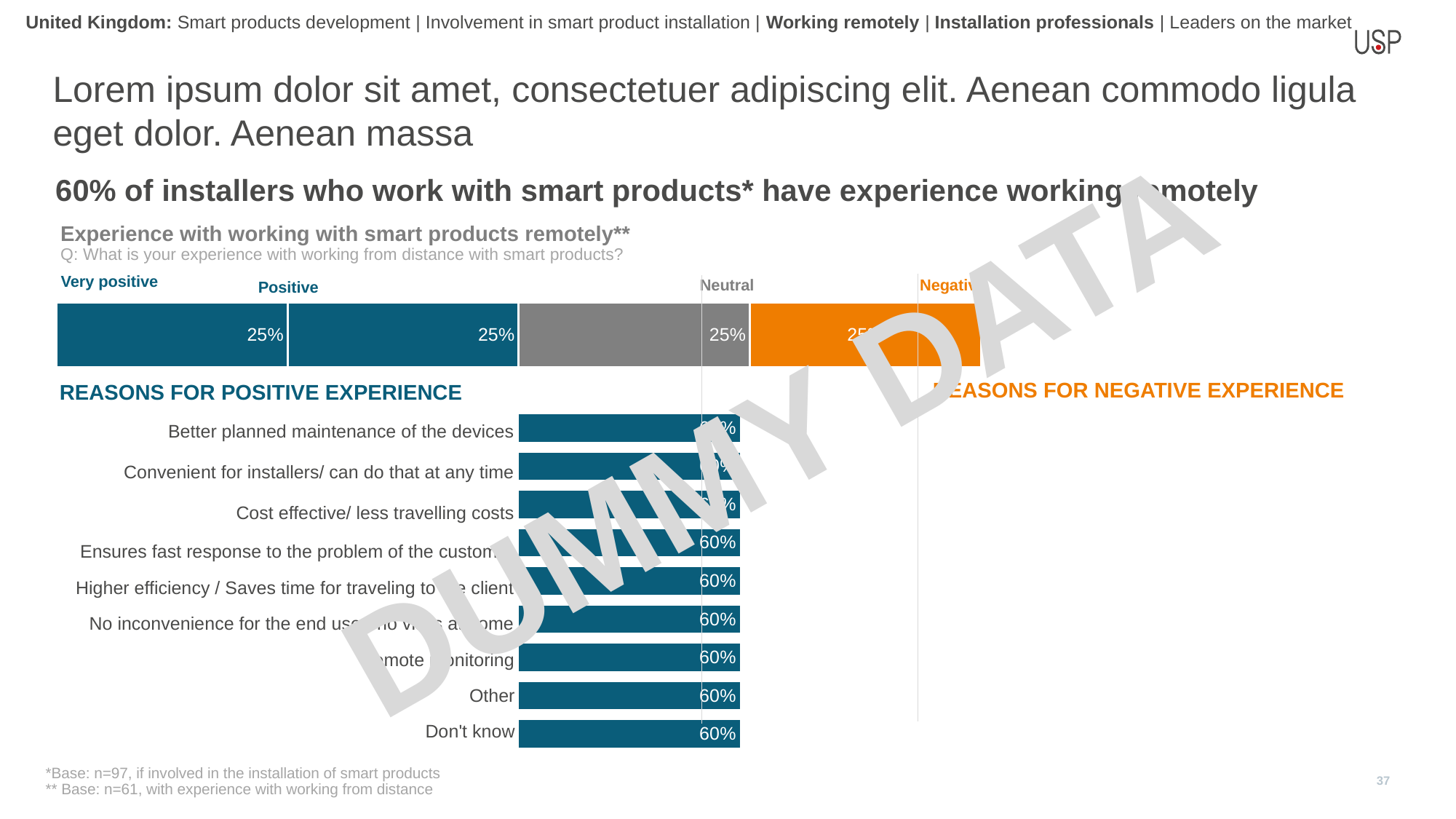
In the 'Experience with working with smart products remotely' chart, what is the combined value of Very positive and Positive? 50% In the 'Experience with working with smart products remotely' chart, what is the value for Positive? 25% What is the title of the chart below the stacked bar on the left side of the slide? Reasons for positive experience What kind of chart is the 'Reasons for positive experience' chart? Bar chart In the 'Reasons for positive experience' chart, what is the value for Don't know? 60% In the 'Reasons for positive experience' chart, what is the value for Other? 60% In the 'Experience with working with smart products remotely' chart, what is the value for Very positive? 25% How many categories are shown in the 'Reasons for positive experience' chart? 9 In the 'Experience with working with smart products remotely' chart, what colour is the Neutral segment? Grey In the 'Reasons for positive experience' chart, what is the difference between the values for Other and Don't know? 0% In the 'Reasons for positive experience' chart, what is the value for 'Higher efficiency / Saves time for traveling to the client'? 60% In the 'Experience with working with smart products remotely' chart, what is the value for Neutral? 25%